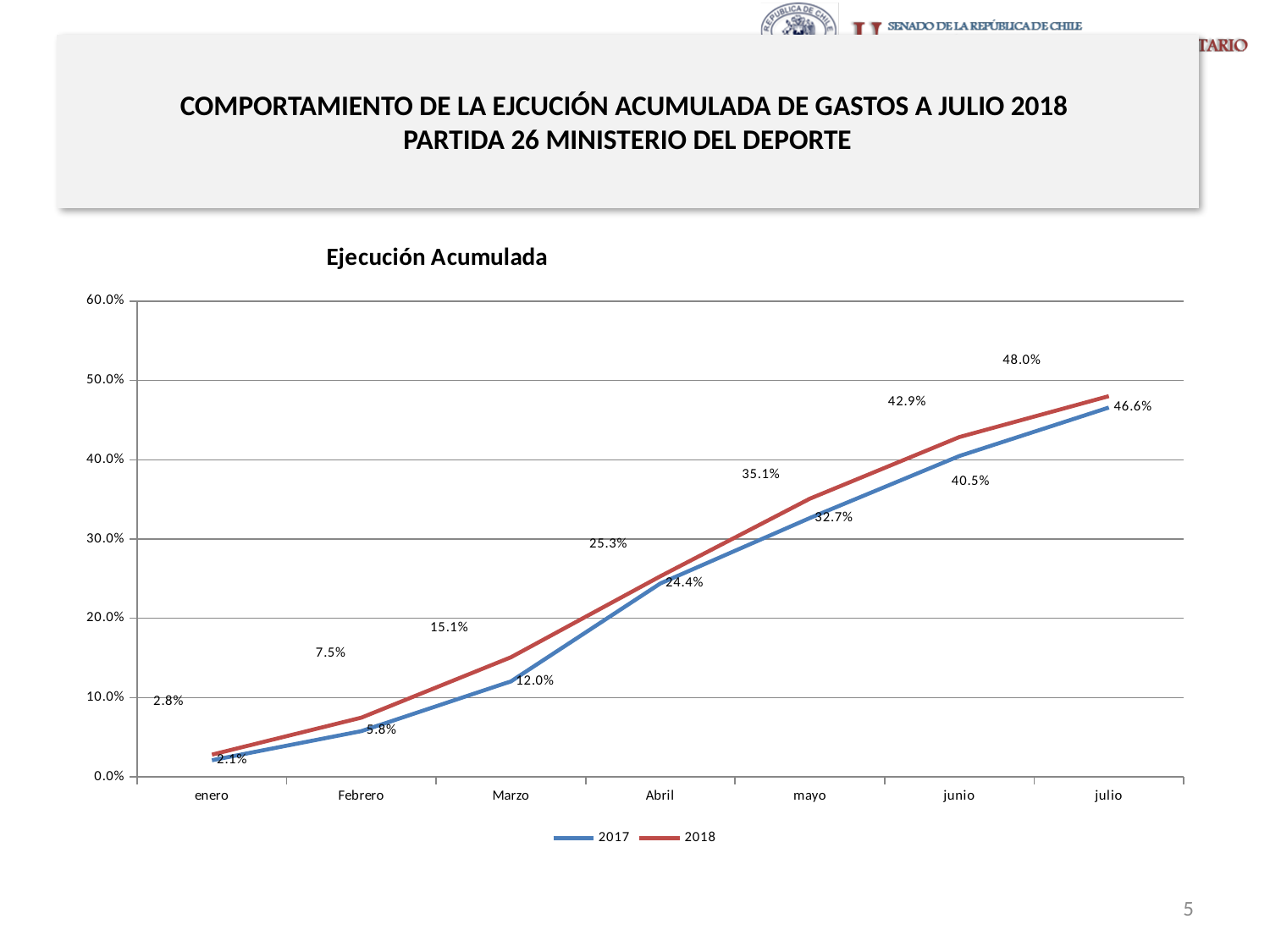
What is the value for 2017 in Abril? 24.4% Which series has the higher value in mayo, 2017 or 2018? 2018 What is the value for 2018 in Marzo? 15.1% Do the values for 2017 rise or fall from enero to julio? rise Which colour is used for the 2018 series? red How many months are plotted along the x axis? 7 What type of chart is shown under the title 'Ejecución Acumulada'? line chart In which month is the 2018 series at its lowest? enero How many series does the legend list? 2 What is the difference between the 2018 and 2017 values in junio? 2.4% What is the value for 2018 in julio? 48.0% What is the value for 2017 in enero? 2.1%